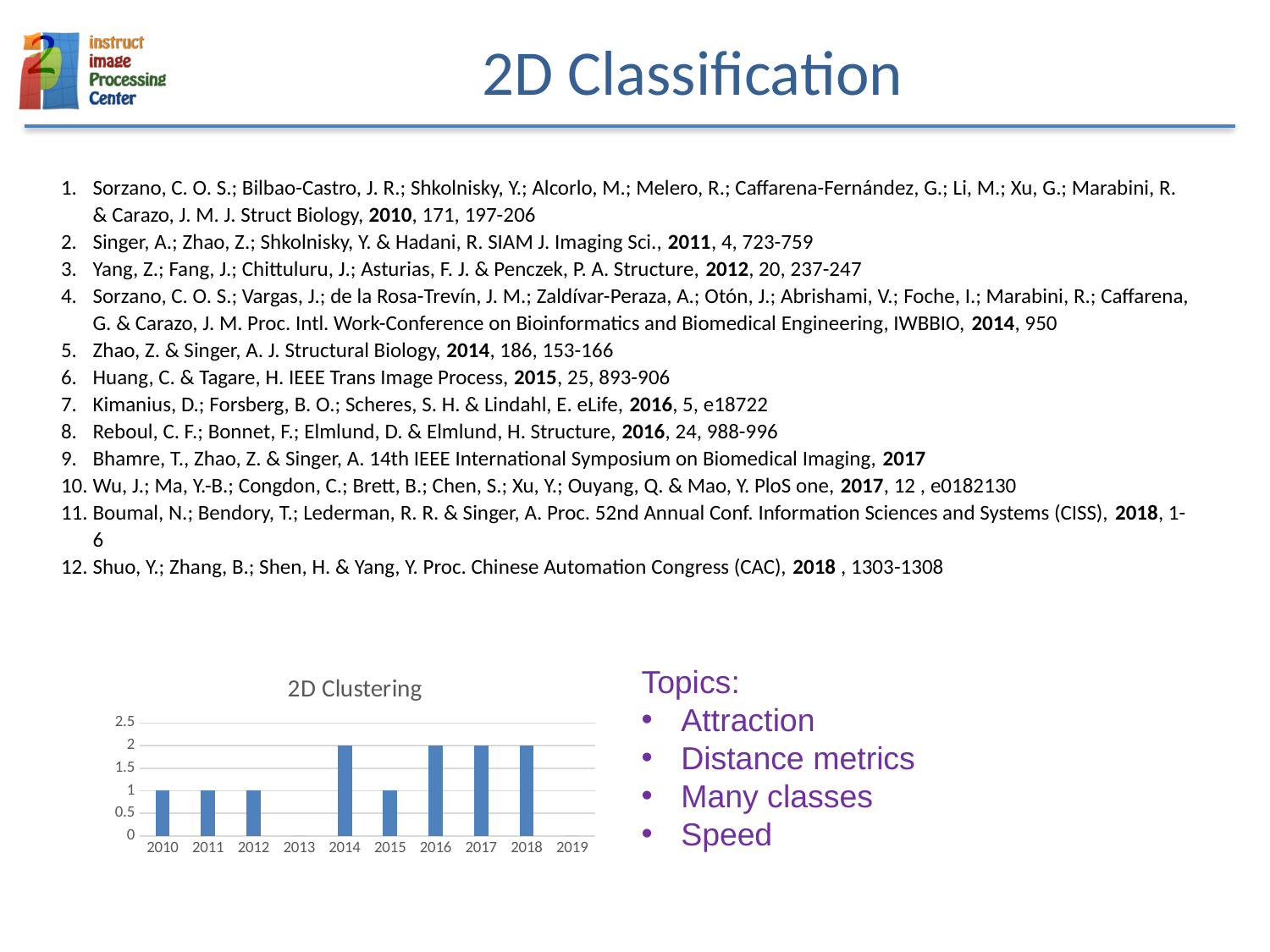
In the "2D Clustering" chart, is the value for 2016 greater or less than 1.5? greater How many year categories are shown on the x axis of the "2D Clustering" chart? 10 In the "2D Clustering" chart, what is the value for 2018? 2 In the "2D Clustering" chart, what is the value for 2014? 2 In the "2D Clustering" chart, what is the value for 2010? 1 In the "2D Clustering" chart, what is the difference between the values for 2017 and 2011? 1 What is the title of the chart on the slide? 2D Clustering What kind of chart is the "2D Clustering" chart? bar chart In the "2D Clustering" chart, is the value for 2011 greater or less than 1.5? less In the "2D Clustering" chart, what is the value for 2015? 1 In the "2D Clustering" chart, which year has a higher value, 2012 or 2016? 2016 In the "2D Clustering" chart, which years have no bar shown? 2013 and 2019